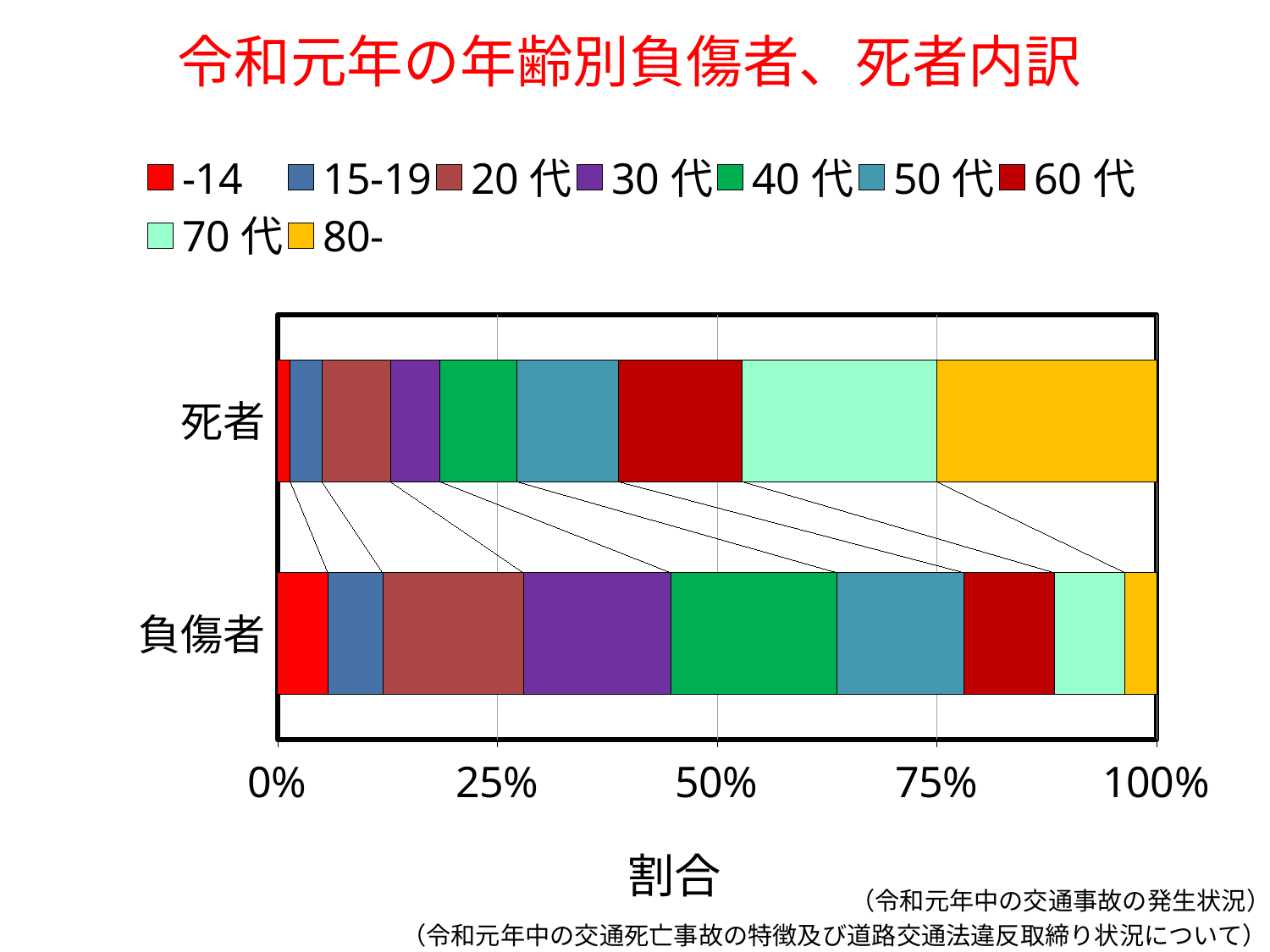
Which age group has the smallest share in the 死者 bar? -14 Is the combined share of 70 代 and 80- in the 死者 bar greater or less than 25%? greater Is the share of 30 代 larger in the 死者 bar or the 負傷者 bar? 負傷者 What is the label of the horizontal axis? 割合 Is the share of 80- in the 負傷者 bar greater or less than 25%? less Is the share of -14 larger in the 死者 bar or the 負傷者 bar? 負傷者 What is the title of the chart? 令和元年の年齢別負傷者、死者内訳 What kind of chart is shown on the slide? Stacked bar chart How many bars (categories) does the chart show? 2 How many series does the legend list? 9 Which age group has the smallest share in the 負傷者 bar? 80- Is the share of 80- larger in the 死者 bar or the 負傷者 bar? 死者